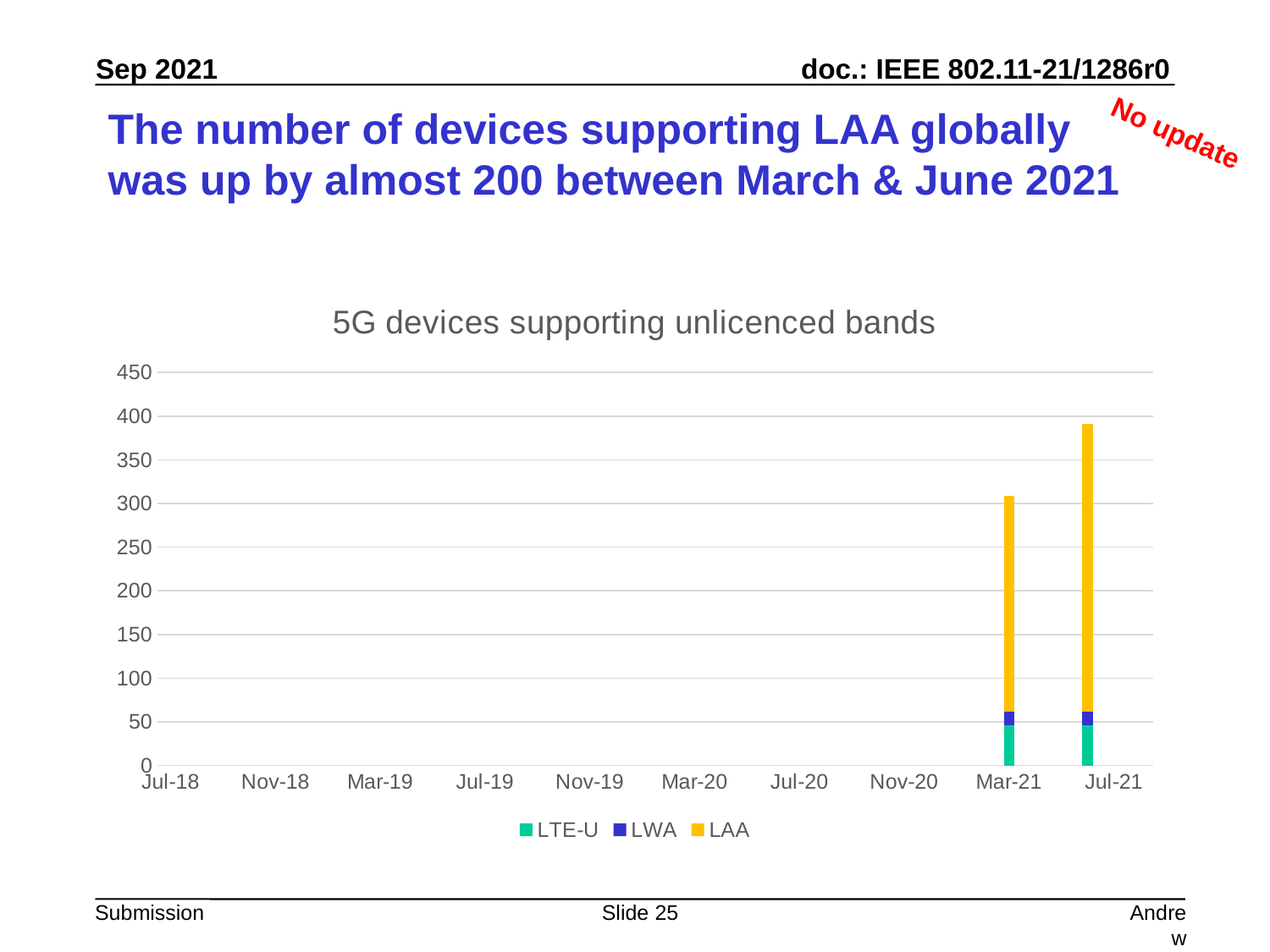
How many x-axis dates have a visible bar plotted? 2 Is the total height of the Mar-21 bar greater or less than 350? less What type of chart is shown on the slide? stacked bar chart Is the total height of the Jul-21 bar greater or less than 350? greater How many series does the chart legend list? 3 Which series makes up the largest portion of the Jul-21 bar? LAA Is the total height of the Jul-21 bar greater or less than 400? less What is the title of the chart? 5G devices supporting unlicenced bands Which series are listed in the chart legend? LTE-U, LWA, LAA Which bar is taller in total, Mar-21 or Jul-21? Jul-21 How many date labels are shown along the x axis? 10